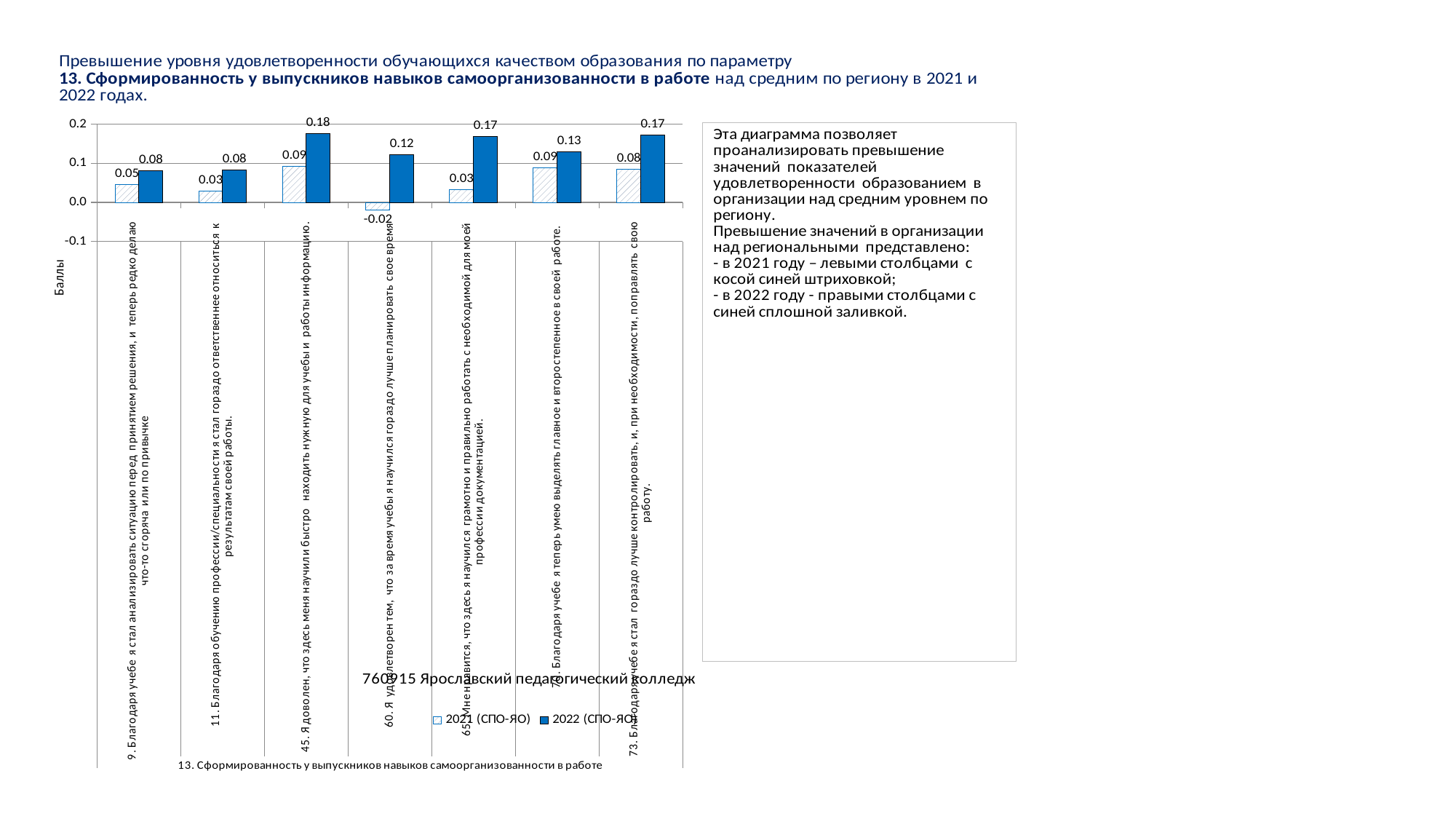
What type of chart is shown on the slide? bar chart What is the 2022 (СПО-ЯО) value for the category numbered 70 ("Благодаря учебе я теперь умею выделять главное и второстепенное в своей работе")? 0.13 What is the difference between the 2022 and 2021 values for the category numbered 65 ("Мне нравится, что здесь я научился грамотно и правильно работать с необходимой для моей профессии документацией")? 0.14 Which category has the lowest 2021 (СПО-ЯО) value? 60. Я удовлетворен тем, что за время учебы я научился гораздо лучше планировать свое время How many series does the chart legend list? 2 What is the 2022 (СПО-ЯО) value for the category numbered 45 ("Я доволен, что здесь меня научили быстро находить нужную для учебы и работы информацию")? 0.18 What is the 2021 (СПО-ЯО) value for the category numbered 60 ("Я удовлетворен тем, что за время учебы я научился гораздо лучше планировать свое время")? -0.02 For the category numbered 9, which series has the larger value, 2021 (СПО-ЯО) or 2022 (СПО-ЯО)? 2022 (СПО-ЯО) Which category has the highest 2022 (СПО-ЯО) value? 45. Я доволен, что здесь меня научили быстро находить нужную для учебы и работы информацию. How many categories are plotted on the x axis of the chart? 7 Is the 2022 (СПО-ЯО) value for the category numbered 73 greater or less than 0.1? greater What is the label of the vertical axis of the chart? Баллы